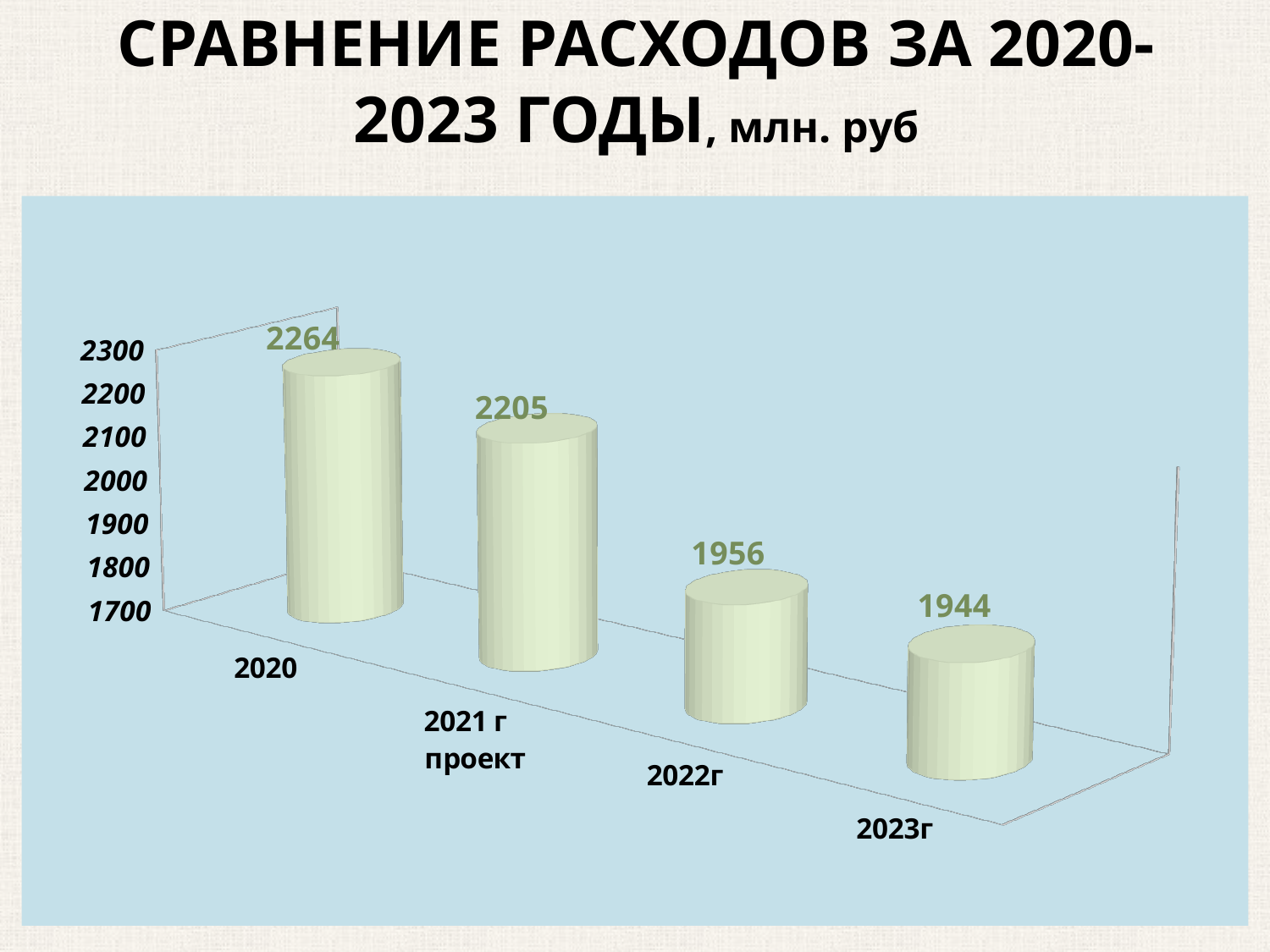
Do the values rise or fall from 2020 to 2023г? Fall Which year has the highest value? 2020 What is the difference between the values for 2021 г проект and 2022г? 249 What is the value for 2020? 2264 Which is larger, the value for 2020 or the value for 2021 г проект? 2020 What is the value for 2021 г проект? 2205 What kind of chart is shown on the slide? Bar chart Which year has the lowest value? 2023г What is the difference between the values for 2020 and 2023г? 320 What is the value for 2023г? 1944 How many categories are shown on the chart? 4 What is the value for 2022г? 1956